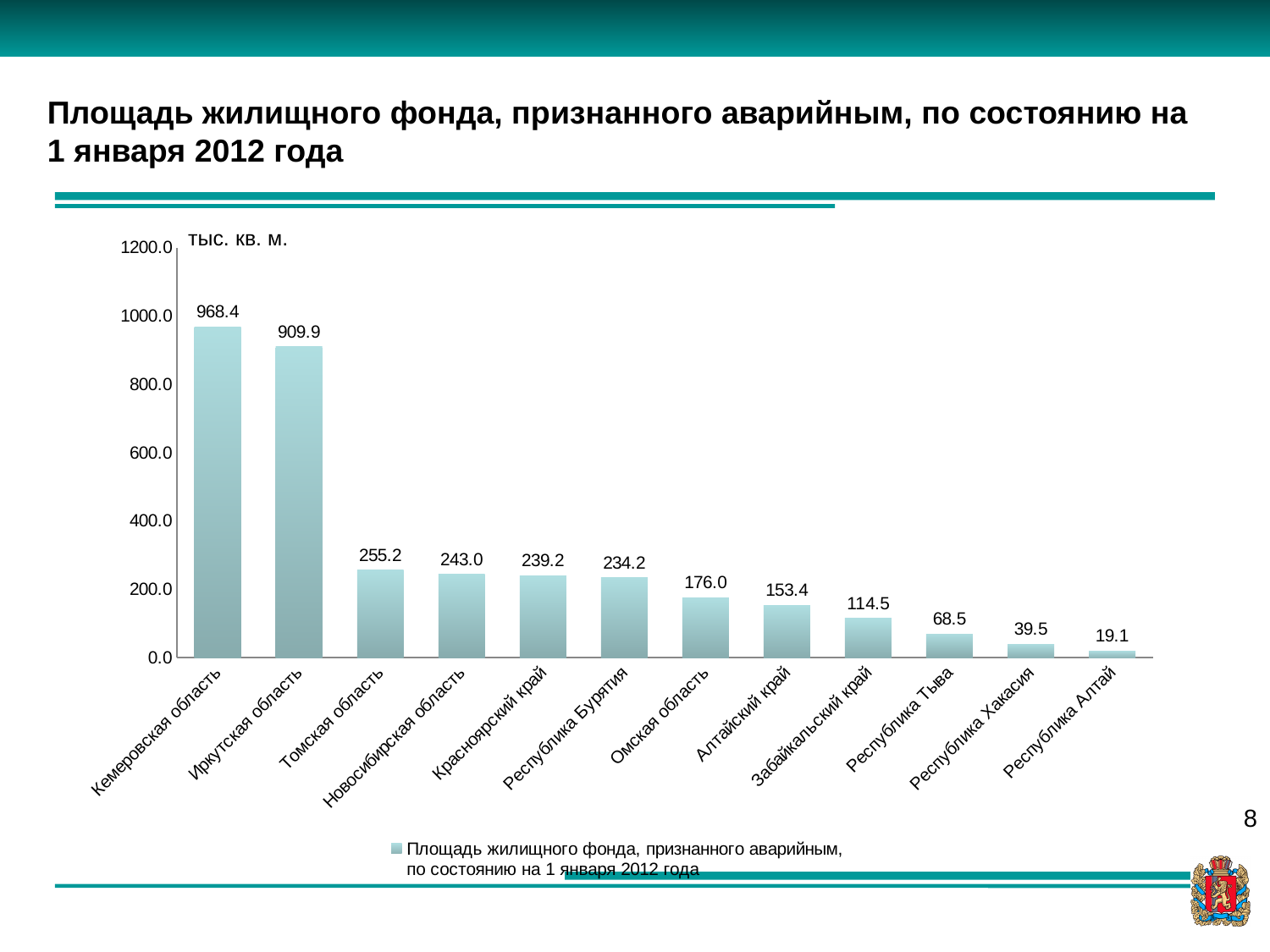
What kind of chart is shown on the slide? bar chart Which region has the highest value? Кемеровская область What is the value for Красноярский край? 239.2 What is the value for Кемеровская область? 968.4 What is the value for Республика Тыва? 68.5 Which region has the lowest value? Республика Алтай Is the value for Республика Бурятия greater or less than 200.0? greater What unit is shown at the top of the vertical axis? тыс. кв. м. Which is larger, the value for Томская область or the value for Забайкальский край? Томская область How many regions are shown on the chart? 12 What is the difference between the values for Кемеровская область and Иркутская область? 58.5 What is the difference between the values for Омская область and Алтайский край? 22.6